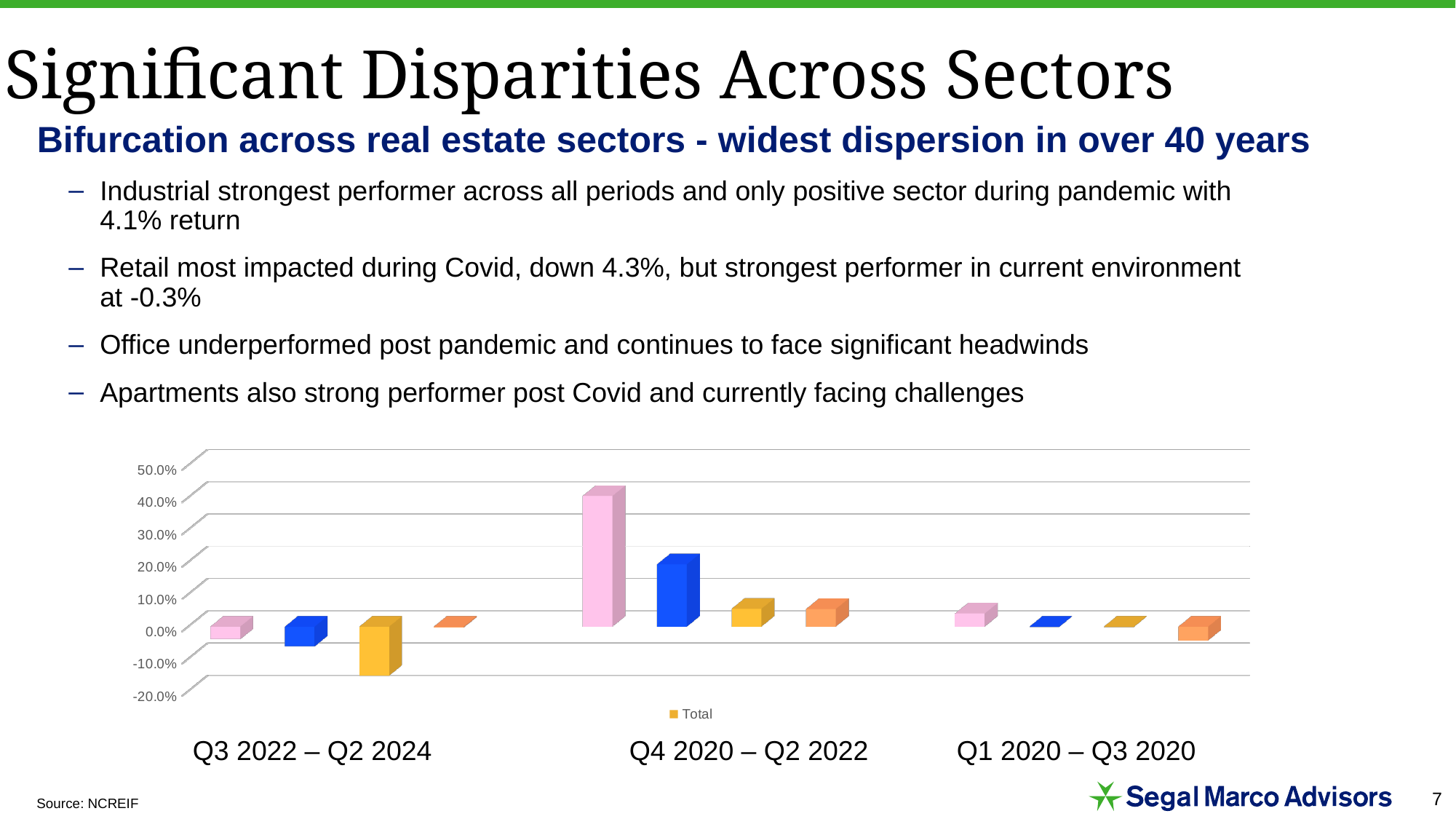
What is the name of the series shown in the chart legend? Total Is the value of the blue bar in the Q4 2020 – Q2 2022 period greater or less than 10.0%? greater What kind of chart is shown on the slide? Bar chart Is the value of the yellow bar in the Q3 2022 – Q2 2024 period greater or less than 0.0%? less In the Q4 2020 – Q2 2022 period, which bar is larger, the pink bar or the blue bar? The pink bar In which period does the tallest bar on the chart appear? Q4 2020 – Q2 2022 Is the value of the orange bar in the Q1 2020 – Q3 2020 period greater or less than 0.0%? less In which period does the lowest (most negative) bar on the chart appear? Q3 2022 – Q2 2024 How many time periods are shown along the x axis of the chart? 3 What is the source cited for the chart data? NCREIF How many series does the chart legend list? 1